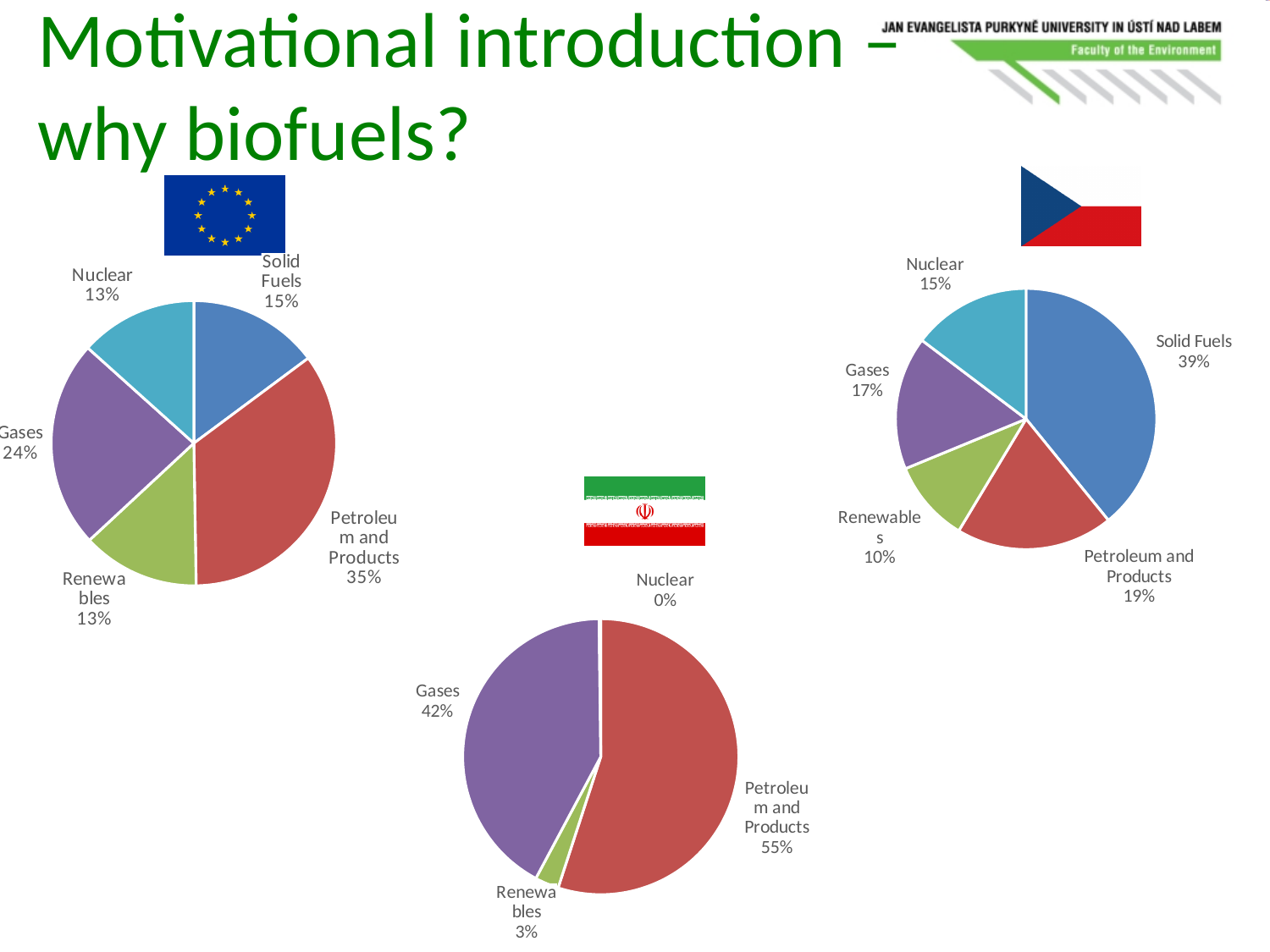
In the pie chart at the bottom centre of the slide, which is larger, Petroleum and Products or Gases? Petroleum and Products In the pie chart on the right of the slide, which category has the smallest share? Renewables In the pie chart on the right of the slide, what share is labelled for Solid Fuels? 39% In the pie chart on the right of the slide, what is the difference between the shares for Solid Fuels and Petroleum and Products? 20% What type of chart is used for the three charts on the slide? Pie chart In the pie chart at the bottom centre of the slide, what share is labelled for Nuclear? 0% How many categories are labelled in the pie chart at the bottom centre of the slide? 4 In the pie chart on the left of the slide, what share is labelled for Petroleum and Products? 35% In the pie chart on the left of the slide, which category has the largest share? Petroleum and Products In the pie chart at the bottom centre of the slide, what share is labelled for Gases? 42% How many categories are labelled in the pie chart on the left of the slide? 5 In the pie chart on the left of the slide, what share is labelled for Gases? 24%